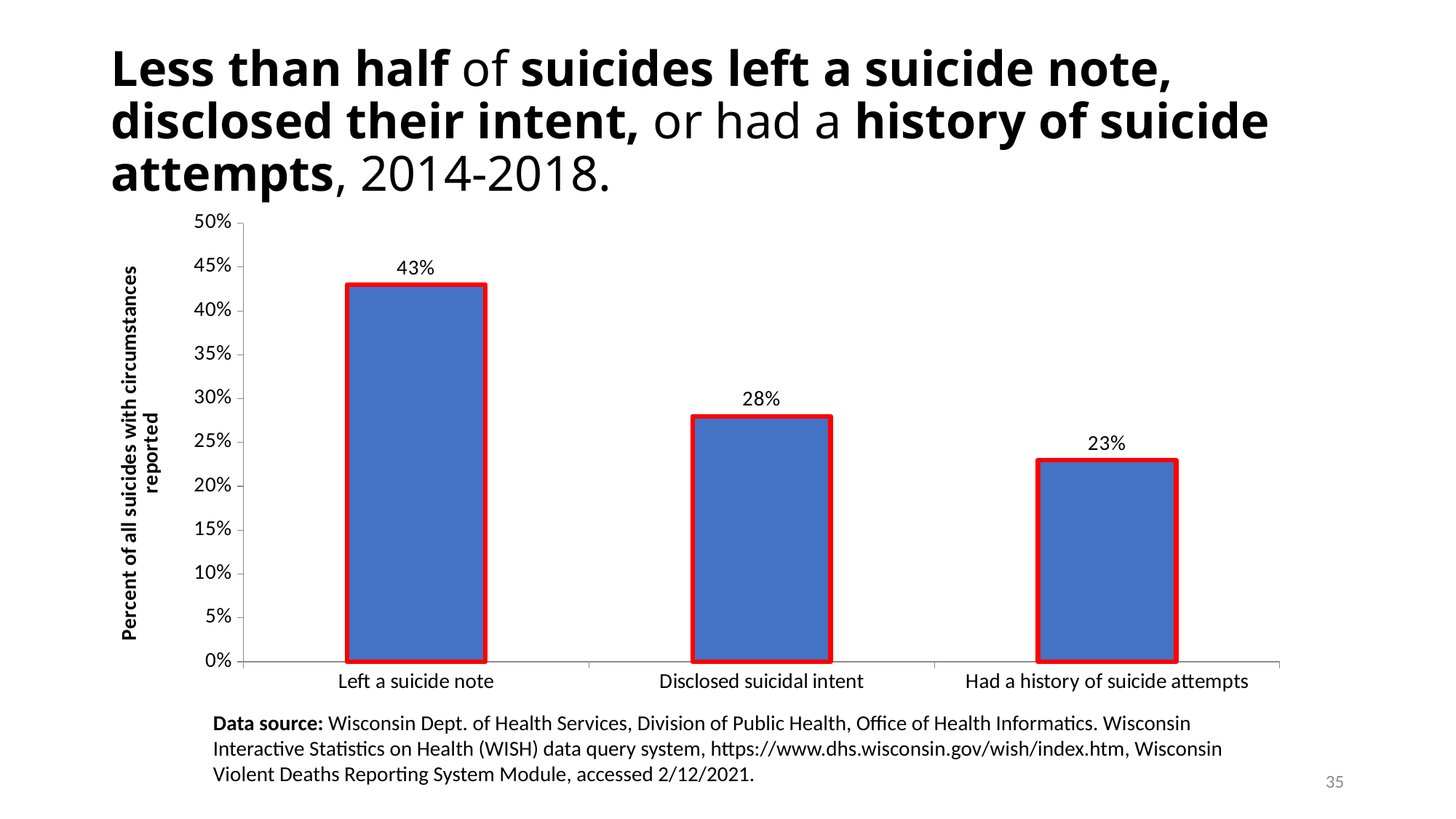
What percent of suicides had a history of suicide attempts? 23% What is the label of the vertical axis? Percent of all suicides with circumstances reported What percent of suicides disclosed suicidal intent? 28% What kind of chart is shown on the slide? Bar chart What percent of suicides left a suicide note? 43% What is the difference in percentage points between 'Disclosed suicidal intent' and 'Had a history of suicide attempts'? 5 percentage points Which circumstance has the lowest percentage? Had a history of suicide attempts Which circumstance has the highest percentage? Left a suicide note What is the difference in percentage points between 'Left a suicide note' and 'Disclosed suicidal intent'? 15 percentage points Which is larger: the percentage that disclosed suicidal intent or the percentage that had a history of suicide attempts? Disclosed suicidal intent How many categories are shown on the x axis? 3 Is the value for 'Left a suicide note' greater or less than 40%? greater